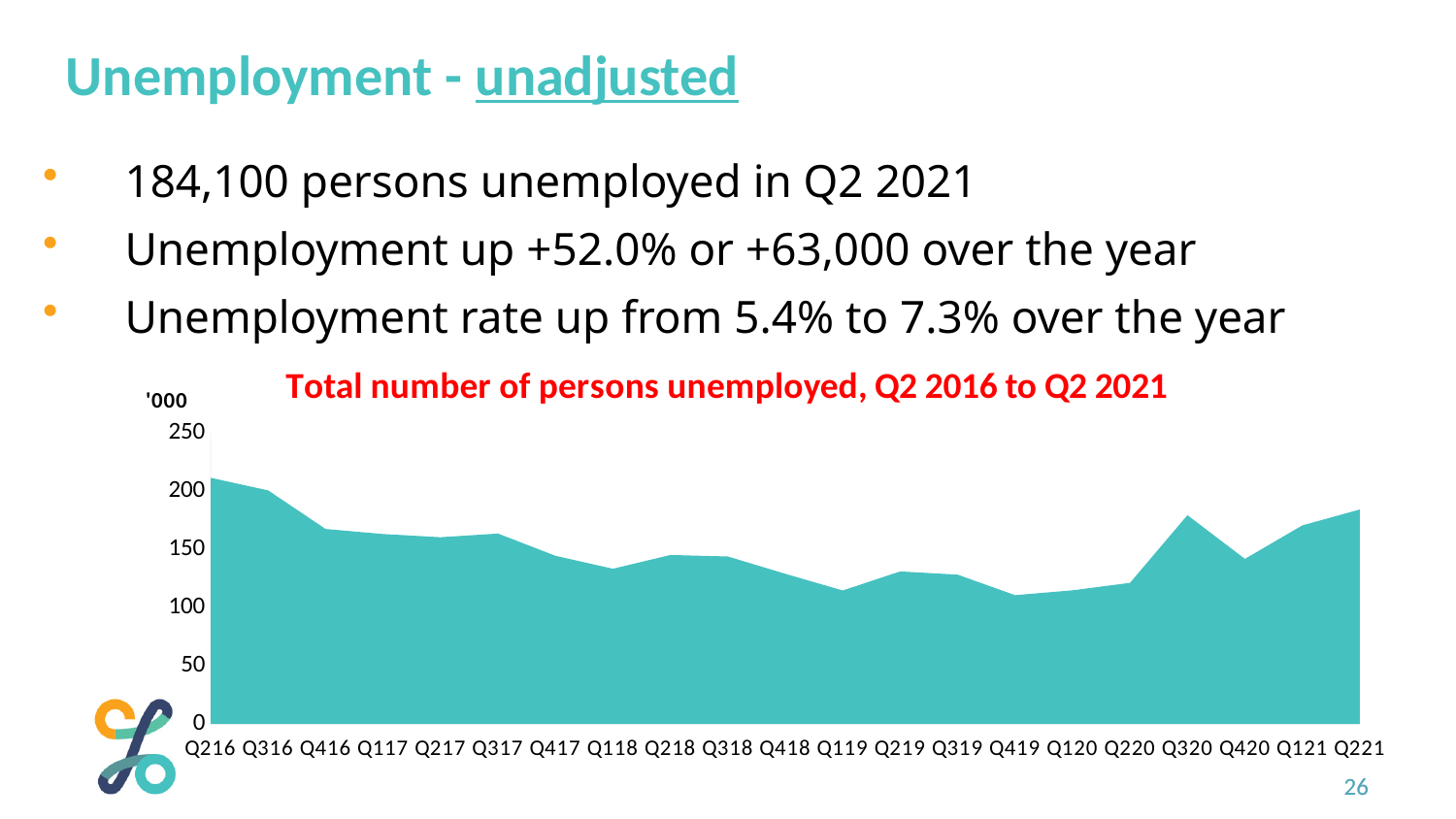
Is the value for Q320 greater or less than 150? greater Which is larger, the value for Q320 or the value for Q420? Q320 Is the value for Q216 greater or less than 200? greater Which is larger, the value for Q216 or the value for Q221? Q216 Which quarter has the highest number of persons unemployed in the chart? Q216 What unit is shown on the vertical axis of the chart? '000 What type of chart is shown on the slide? Area chart What is the title of the chart? Total number of persons unemployed, Q2 2016 to Q2 2021 Do the values generally rise or fall from Q216 to Q419? fall How many quarters are plotted along the x axis of the chart? 21 Is the value for Q419 greater or less than 150? less